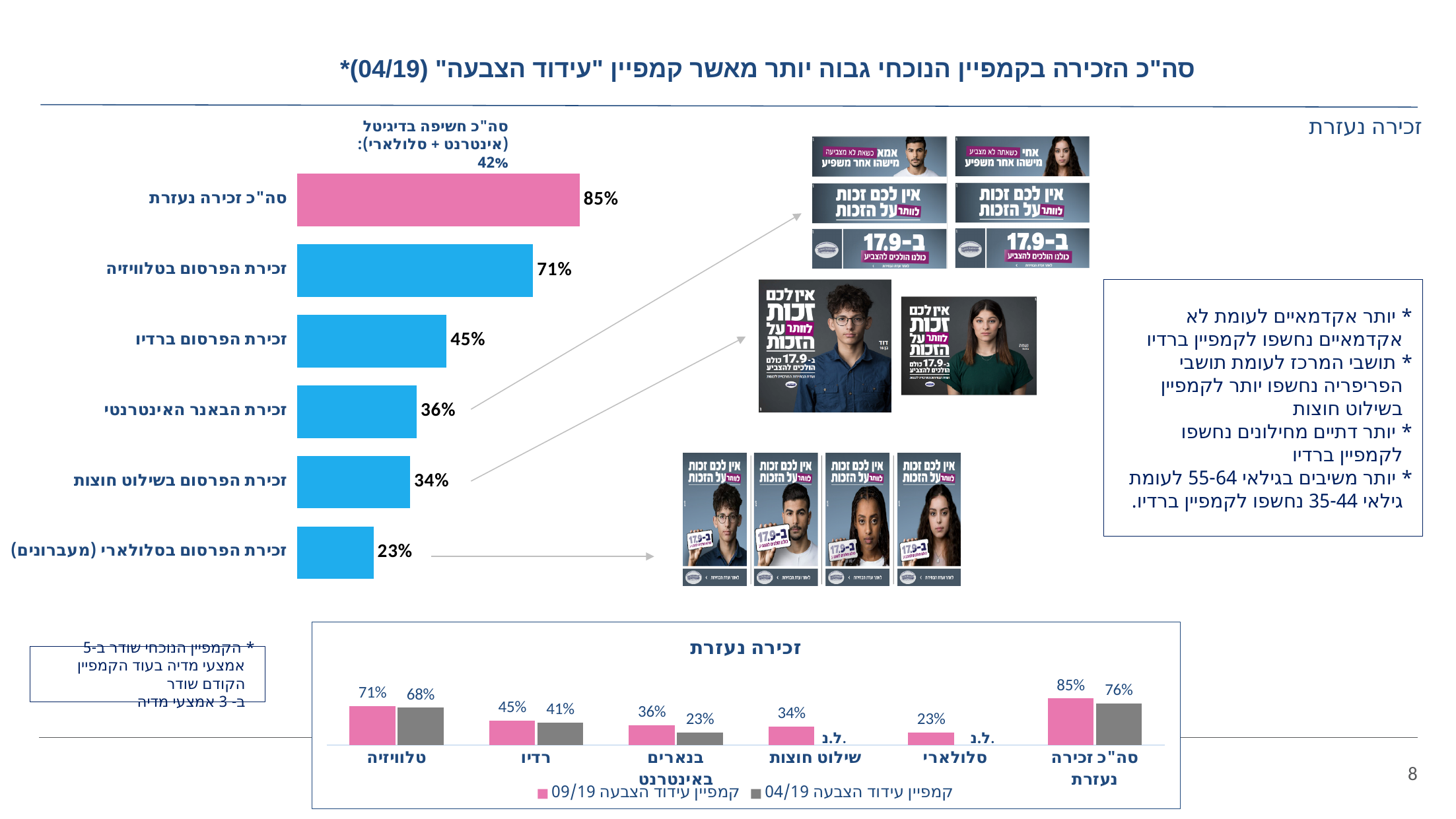
In the horizontal bar chart on the upper left, which category has the lowest value? זכירת הפרסום בסלולארי (מעברונים) In the horizontal bar chart on the upper left, which category has the highest value? סה"כ זכירה נעזרת What kind of chart is the chart on the upper left of the slide? bar chart In the horizontal bar chart on the upper left, what is the value for זכירת הפרסום בסלולארי (מעברונים)? 23% In the bottom chart titled זכירה נעזרת, which is larger for סה"כ זכירה נעזרת: the 09/19 value or the 04/19 value? 09/19 In the horizontal bar chart on the upper left, what is the value for זכירת הפרסום בטלוויזיה? 71% In the bottom chart titled זכירה נעזרת, what is the difference between the 09/19 and 04/19 values for בנארים באינטרנט? 13% In the horizontal bar chart on the upper left, what is the difference between זכירת הפרסום בטלוויזיה and זכירת הפרסום ברדיו? 26% In the bottom chart titled זכירה נעזרת, what is the 04/19 value for טלוויזיה? 68% In the horizontal bar chart on the upper left, how many categories are shown? 6 In the bottom chart titled זכירה נעזרת, what is the 09/19 value for בנארים באינטרנט? 36% In the bottom chart titled זכירה נעזרת, how many series does the legend list? 2